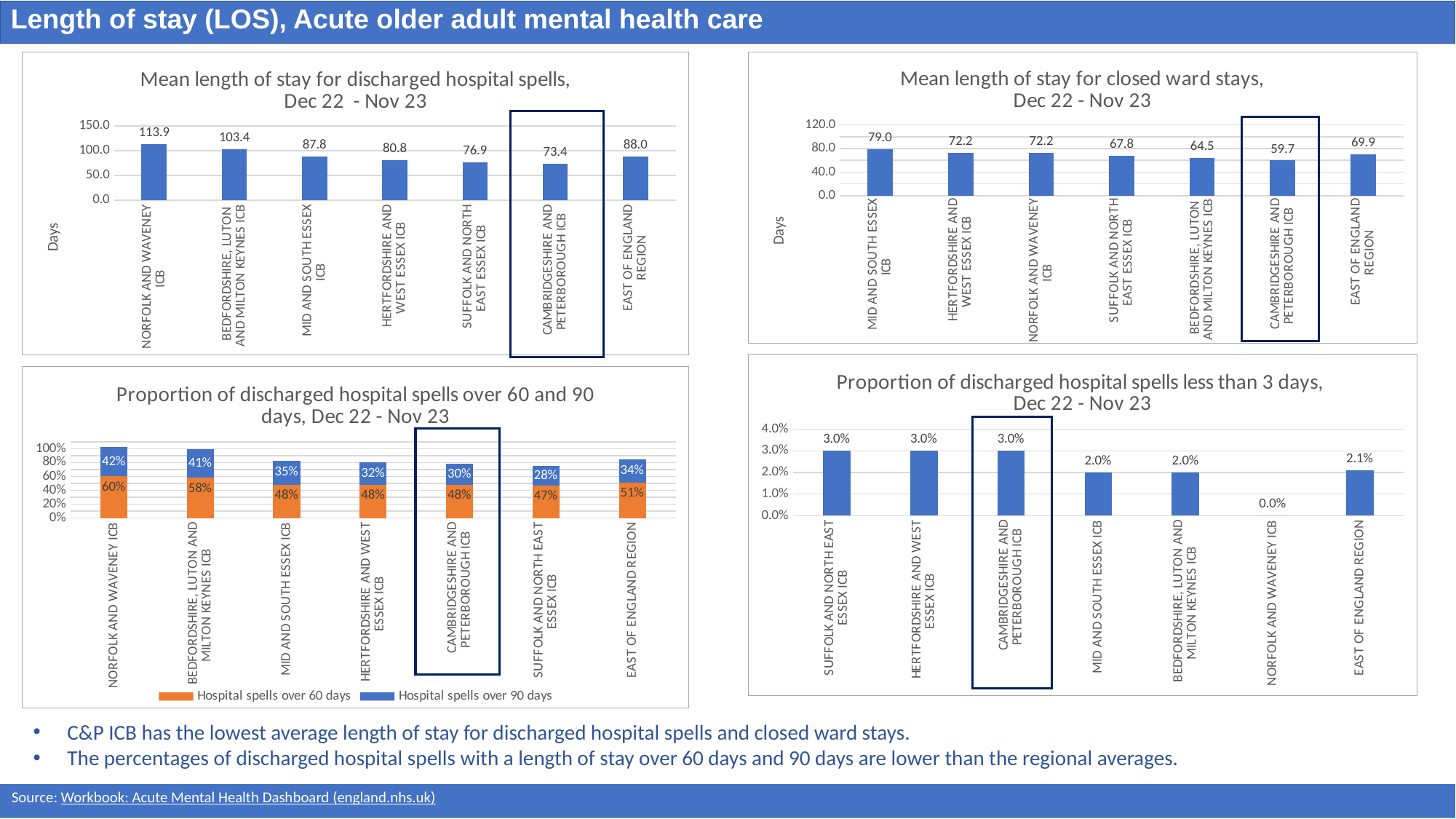
In the chart 'Proportion of discharged hospital spells less than 3 days, Dec 22 - Nov 23', what is the value for East of England Region? 2.1% In the chart 'Mean length of stay for closed ward stays, Dec 22 - Nov 23', which category has the highest value? Mid and South Essex ICB In the chart 'Proportion of discharged hospital spells over 60 and 90 days, Dec 22 - Nov 23', how many series does the legend list? 2 In the chart 'Mean length of stay for discharged hospital spells, Dec 22 - Nov 23', what is the difference between the values for Norfolk and Waveney ICB and East of England Region? 25.9 In the chart 'Mean length of stay for discharged hospital spells, Dec 22 - Nov 23', what is the value for Norfolk and Waveney ICB? 113.9 In the chart 'Proportion of discharged hospital spells less than 3 days, Dec 22 - Nov 23', which category has the lowest value? Norfolk and Waveney ICB What kind of chart is 'Mean length of stay for discharged hospital spells, Dec 22 - Nov 23'? Bar chart In the chart 'Proportion of discharged hospital spells over 60 and 90 days, Dec 22 - Nov 23', what is the value of Hospital spells over 90 days for Cambridgeshire and Peterborough ICB? 30% In the chart 'Mean length of stay for closed ward stays, Dec 22 - Nov 23', what is the value for Cambridgeshire and Peterborough ICB? 59.7 In the chart 'Mean length of stay for discharged hospital spells, Dec 22 - Nov 23', which category has the lowest value? Cambridgeshire and Peterborough ICB In the chart 'Mean length of stay for closed ward stays, Dec 22 - Nov 23', how many categories are shown? 7 In the chart 'Proportion of discharged hospital spells over 60 and 90 days, Dec 22 - Nov 23', which series is shown in orange? Hospital spells over 60 days